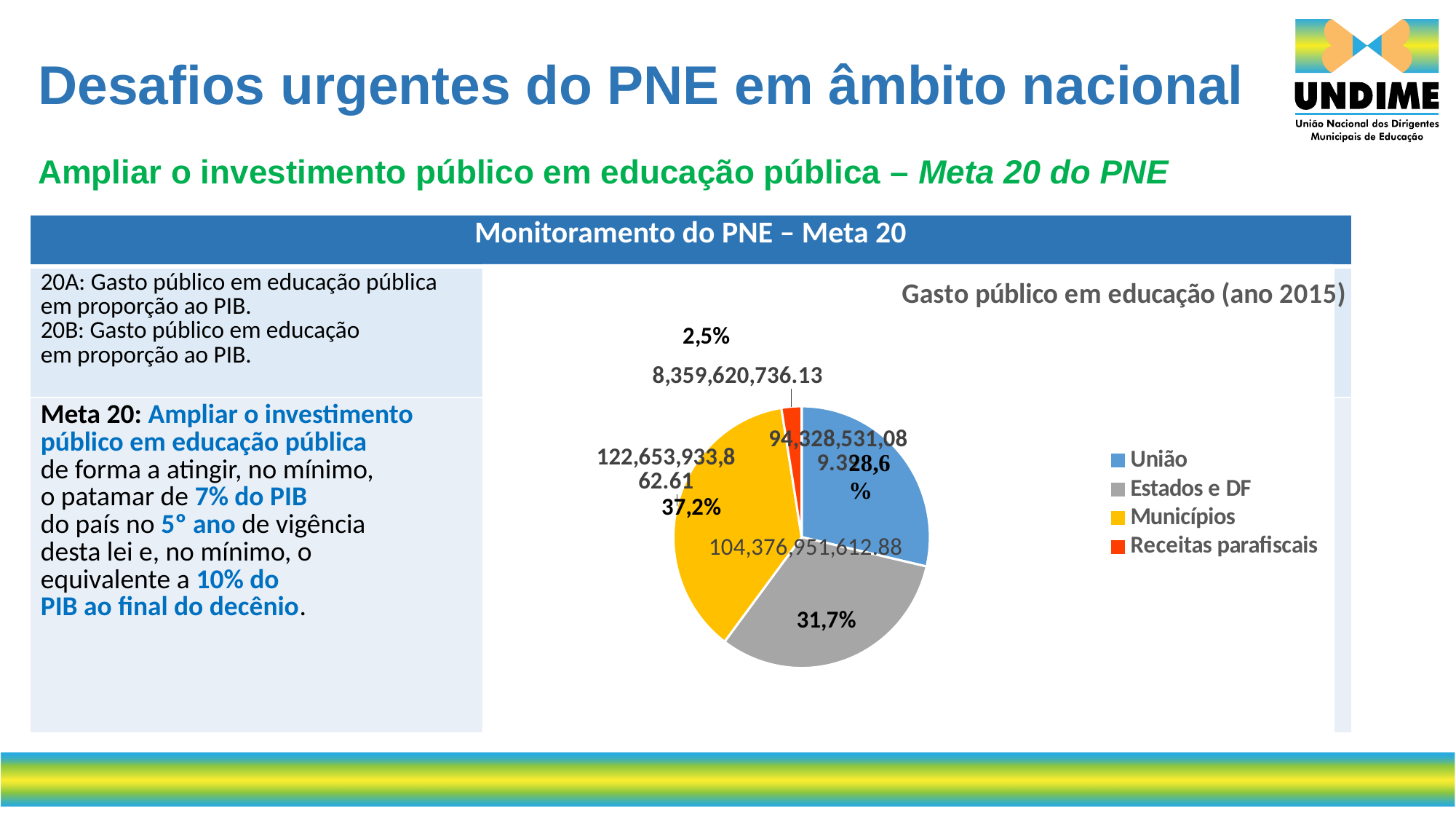
What share of the pie does Estados e DF represent? 31,7% What kind of chart is shown on the slide? pie chart How many entries does the legend of the pie chart list? 4 What share of the pie does Municípios represent? 37,2% How many slices does the pie chart have? 4 What is the title of the pie chart? Gasto público em educação (ano 2015) What share of the pie does Receitas parafiscais represent? 2,5% What value is labelled for the Receitas parafiscais slice? 8,359,620,736.13 Which is larger, the share for Estados e DF or the share for União? Estados e DF Which category has the largest slice of the pie? Municípios Which category has the smallest slice of the pie? Receitas parafiscais